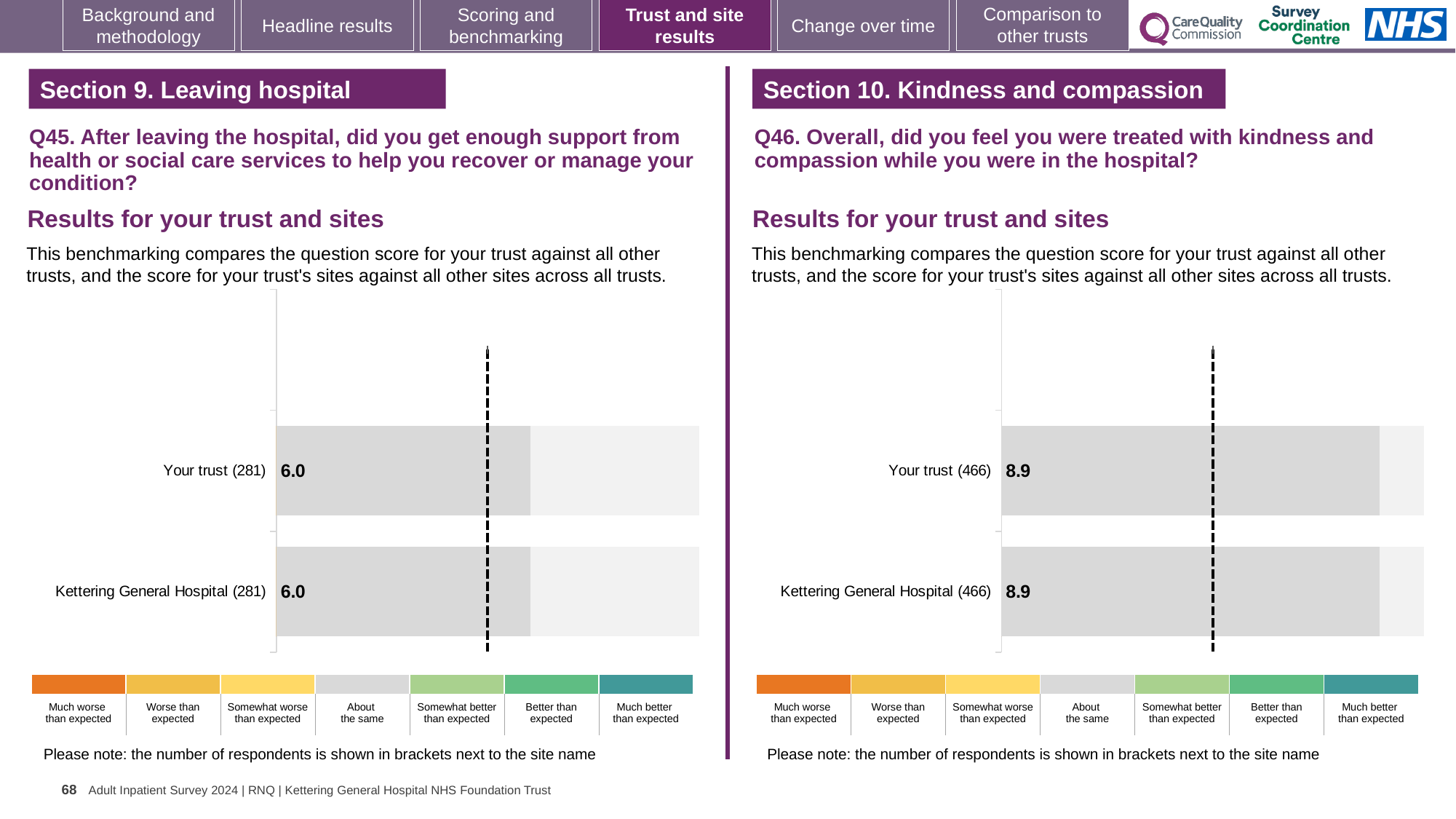
On the Q46 chart (right), what is the score for Kettering General Hospital? 8.9 On the Q46 chart (right), how many bars are plotted? 2 On the Q45 chart (left), what is the difference between the score for Your trust and the score for Kettering General Hospital? 0.0 On the Q46 chart (right), what is the score for Your trust? 8.9 What kind of chart is shown on the left for Q45? Bar chart On the Q45 chart (left), how many respondents are shown in brackets next to Your trust? 281 On the Q46 chart (right), how many respondents are shown in brackets next to Kettering General Hospital? 466 On the Q45 chart (left), what is the score for Kettering General Hospital? 6.0 What is the difference between the Your trust score on the Q46 chart (right) and the Your trust score on the Q45 chart (left)? 2.9 On the Q45 chart (left), how many bars are plotted? 2 Is the score for Your trust on the Q46 chart (right) larger or smaller than the score for Your trust on the Q45 chart (left)? Larger On the Q45 chart (left), what is the score for Your trust? 6.0